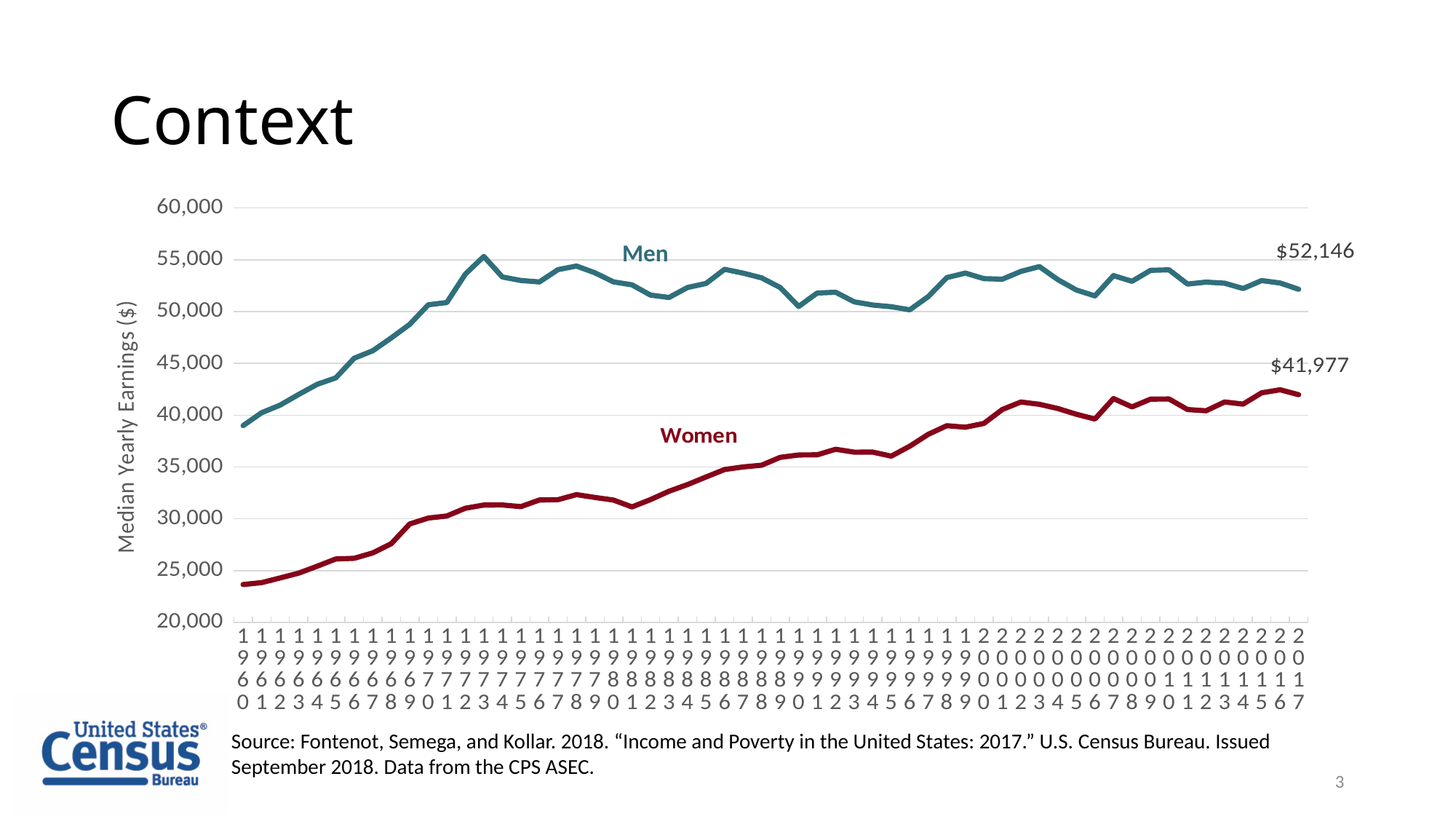
What is the label on the vertical axis of the chart? Median Yearly Earnings ($) In 2017, which series has the higher median yearly earnings, Men or Women? Men Is the value for Men in 1960 greater or less than 40,000? less What is the difference between the labelled 2017 values for Men and Women? $10,169 Does the Women series generally rise or fall from 1960 to 2017? rise What kind of chart is shown on the slide? line chart What is the labelled value for Men at the end of the series in 2017? $52,146 What is the labelled value for Women at the end of the series in 2017? $41,977 Is the value for Women in 1960 greater or less than 25,000? less How many series are plotted on the chart? 2 Is the value for Women in 2010 greater or less than 40,000? greater